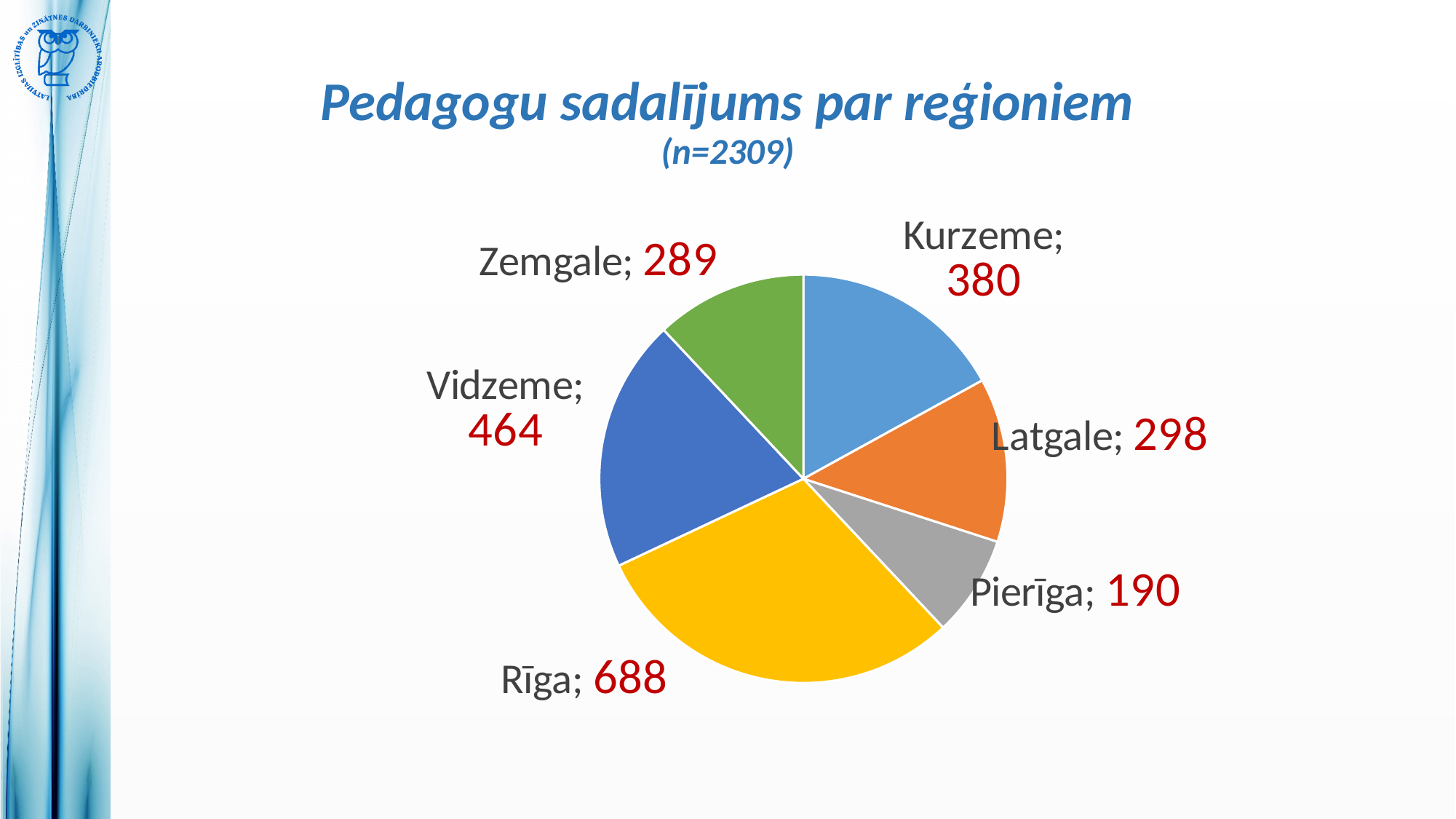
Which is larger, the value for Kurzeme or the value for Latgale? Kurzeme Which region has the lowest value? Pierīga What is the title of the chart? Pedagogu sadalījums par reģioniem Which region has the highest value? Rīga How many regions are shown in the pie chart? 6 What is the value for Rīga? 688 What is the difference between the values for Latgale and Zemgale? 9 What is the value for Pierīga? 190 What is the value for Vidzeme? 464 What is the value for Kurzeme? 380 What is the difference between the values for Rīga and Vidzeme? 224 What type of chart is shown on the slide? pie chart